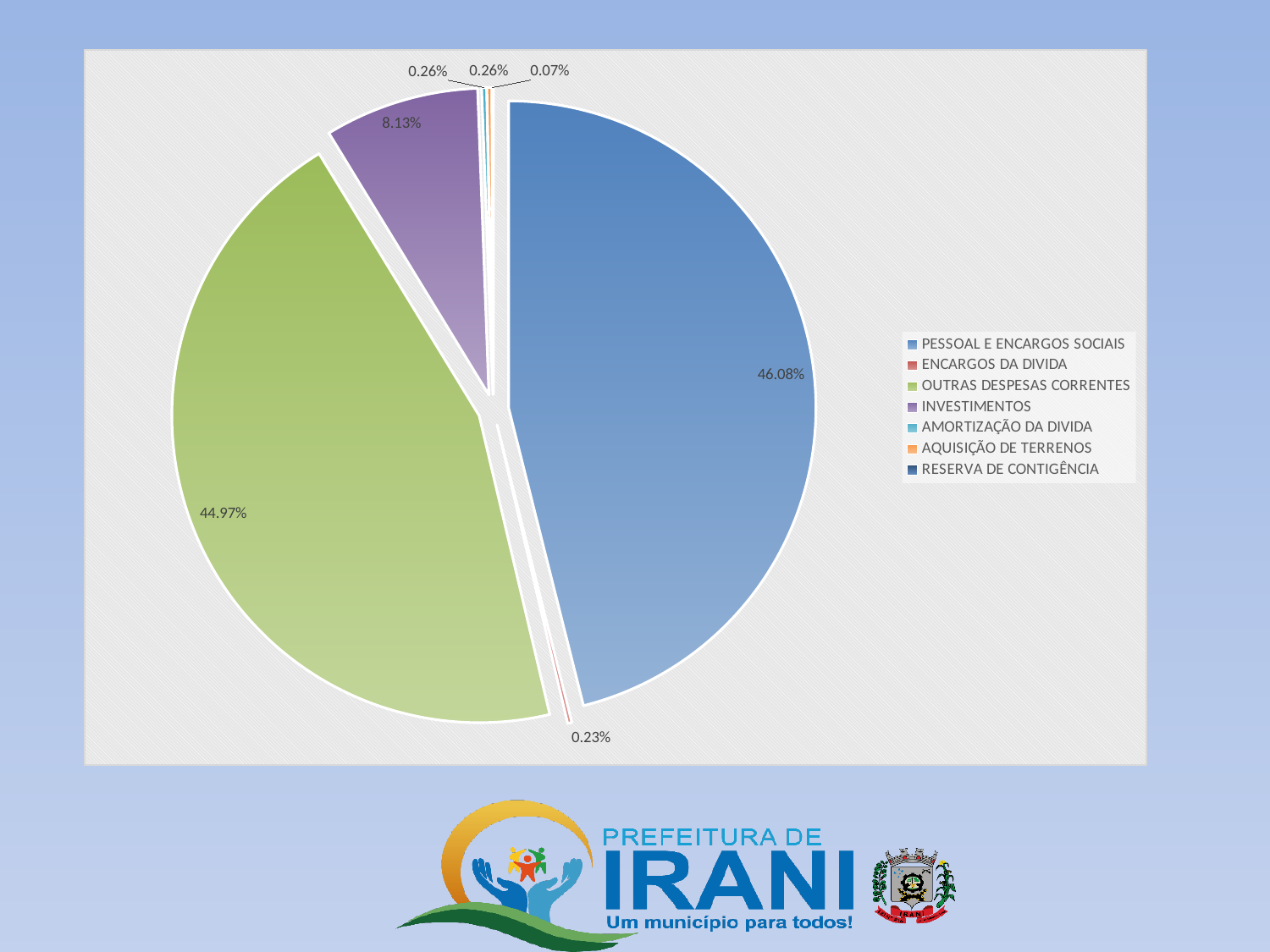
What colour is the INVESTIMENTOS slice? purple What percentage does the PESSOAL E ENCARGOS SOCIAIS slice represent? 46.08% What kind of chart is shown on the slide? pie chart What percentage does the RESERVA DE CONTIGÊNCIA slice represent? 0.07% What percentage does the INVESTIMENTOS slice represent? 8.13% What percentage does the AQUISIÇÃO DE TERRENOS slice represent? 0.26% How many categories does the legend list? 7 Which category has the largest share of the pie? PESSOAL E ENCARGOS SOCIAIS What percentage does the OUTRAS DESPESAS CORRENTES slice represent? 44.97% Which category has the smallest share of the pie? RESERVA DE CONTIGÊNCIA What percentage does the ENCARGOS DA DIVIDA slice represent? 0.23% What is the difference in percentage points between PESSOAL E ENCARGOS SOCIAIS and OUTRAS DESPESAS CORRENTES? 1.11